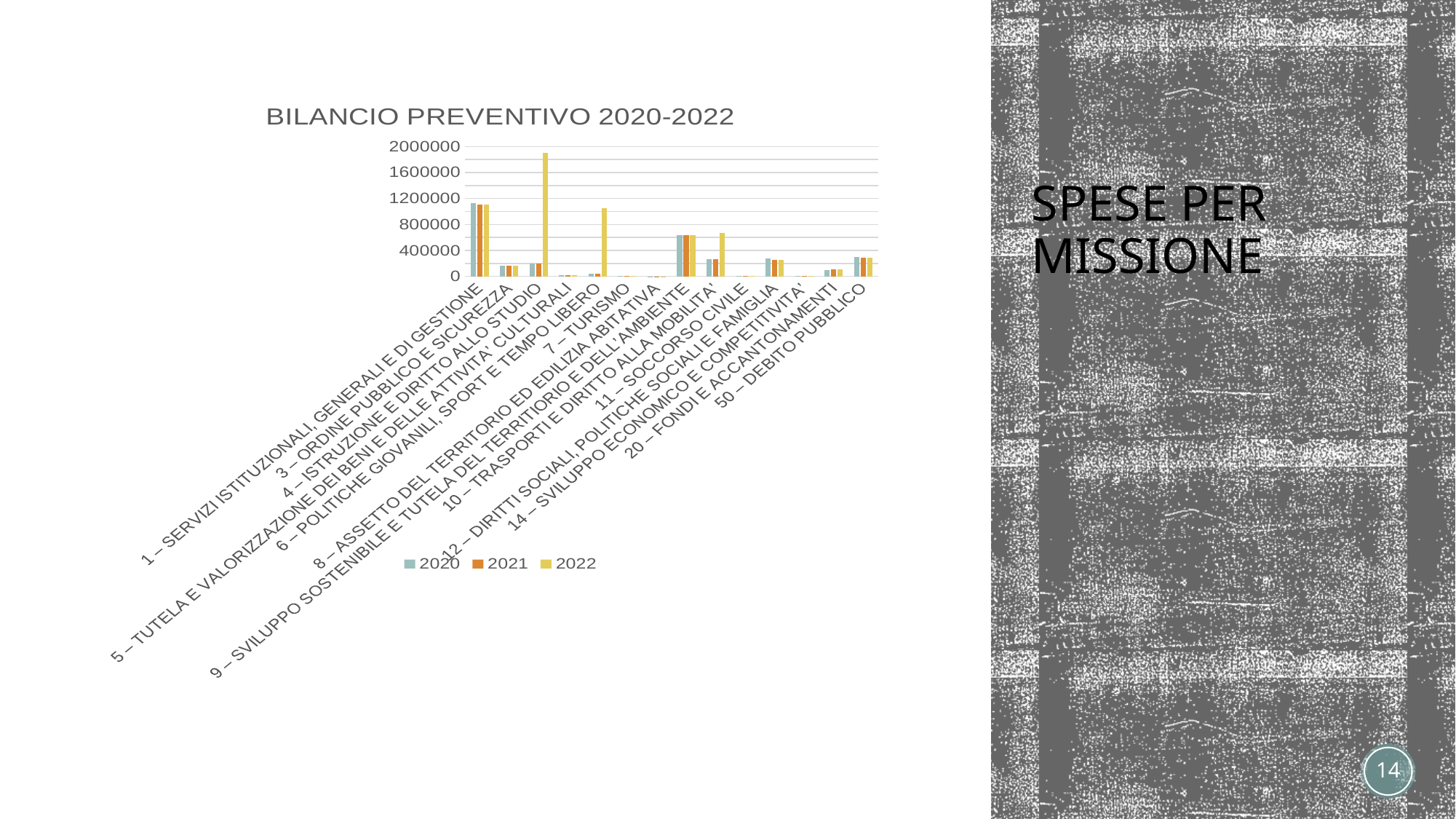
How many series does the legend list? 3 Which category has the tallest bar in the chart? 4 – ISTRUZIONE E DIRITTO ALLO STUDIO For '6 – POLITICHE GIOVANILI, SPORT E TEMPO LIBERO', which is larger, the 2021 value or the 2022 value? 2022 For '10 – TRASPORTI E DIRITTO ALLA MOBILITA'', which is larger, the 2020 value or the 2022 value? 2022 Is the 2020 value for '1 – SERVIZI ISTITUZIONALI, GENERALI E DI GESTIONE' greater or less than 800000? greater What type of chart is shown on the slide? Bar chart Is the 2020 value for '3 – ORDINE PUBBLICO E SICUREZZA' greater or less than 400000? less Is the 2022 value for '4 – ISTRUZIONE E DIRITTO ALLO STUDIO' greater or less than 1600000? greater For the category '4 – ISTRUZIONE E DIRITTO ALLO STUDIO', which year has the highest value? 2022 How many categories (missioni) are shown on the x axis? 14 What is the title of the chart? BILANCIO PREVENTIVO 2020-2022